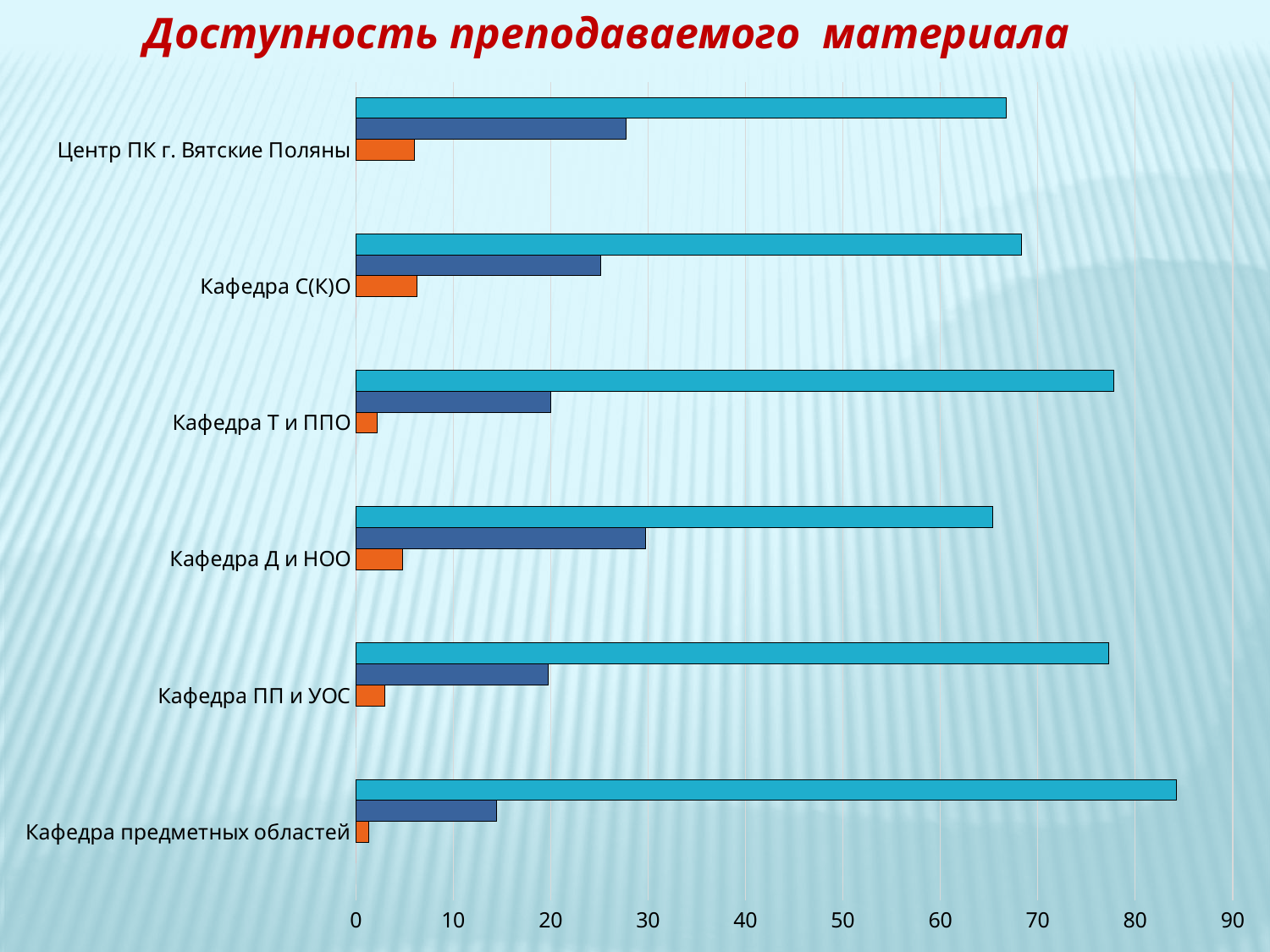
How many categories are shown on the chart? 6 Which category has the shortest dark blue bar? Кафедра предметных областей How many bars are drawn for each category? 3 Is the light blue bar for Кафедра Т и ППО greater or less than 70? greater Is the light blue bar for Центр ПК г. Вятские Поляны greater or less than 70? less What is the title of the chart? Доступность преподаваемого материала Is the dark blue bar for Кафедра предметных областей greater or less than 20? less What kind of chart is shown on the slide? bar chart Which has the longer dark blue bar, Кафедра Д и НОО or Кафедра ПП и УОС? Кафедра Д и НОО Which has the longer light blue bar, Кафедра Т и ППО or Кафедра С(К)О? Кафедра Т и ППО Which category has the longest light blue bar? Кафедра предметных областей